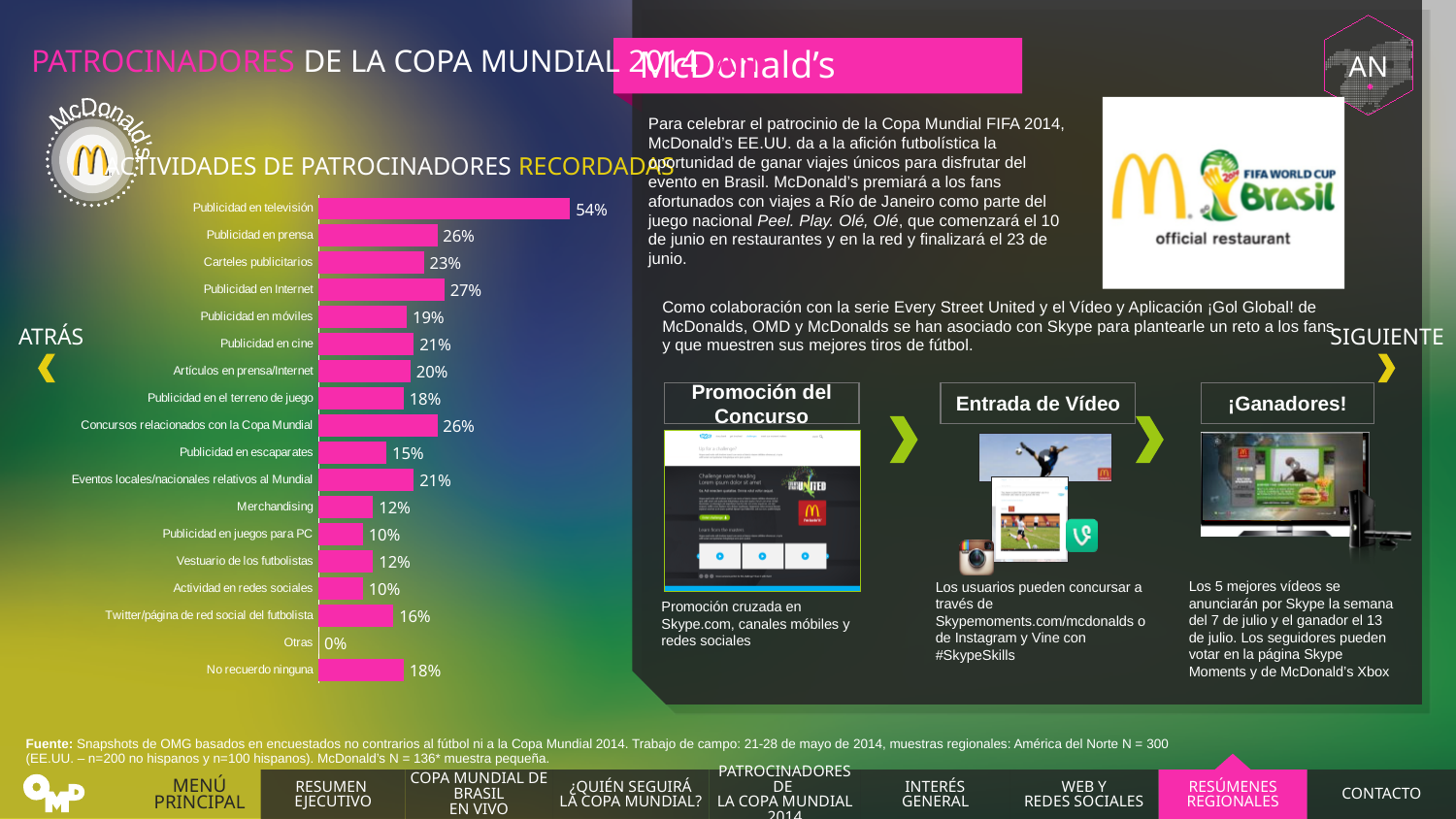
Which is larger, the value for Publicidad en móviles or the value for Publicidad en cine? Publicidad en cine What value is shown for Merchandising? 12% What value is shown for No recuerdo ninguna? 18% What is the difference between the values for Carteles publicitarios and Publicidad en escaparates? 8% What kind of chart is shown on the slide? Bar chart What value is shown for Publicidad en Internet? 27% Which category has the lowest value in the chart? Otras What is the difference between the values for Publicidad en televisión and Publicidad en prensa? 28% How many categories are shown in the bar chart? 18 Which is larger, the value for Twitter/página de red social del futbolista or the value for Actividad en redes sociales? Twitter/página de red social del futbolista Which category has the highest value in the chart? Publicidad en televisión What value is shown for Publicidad en televisión? 54%